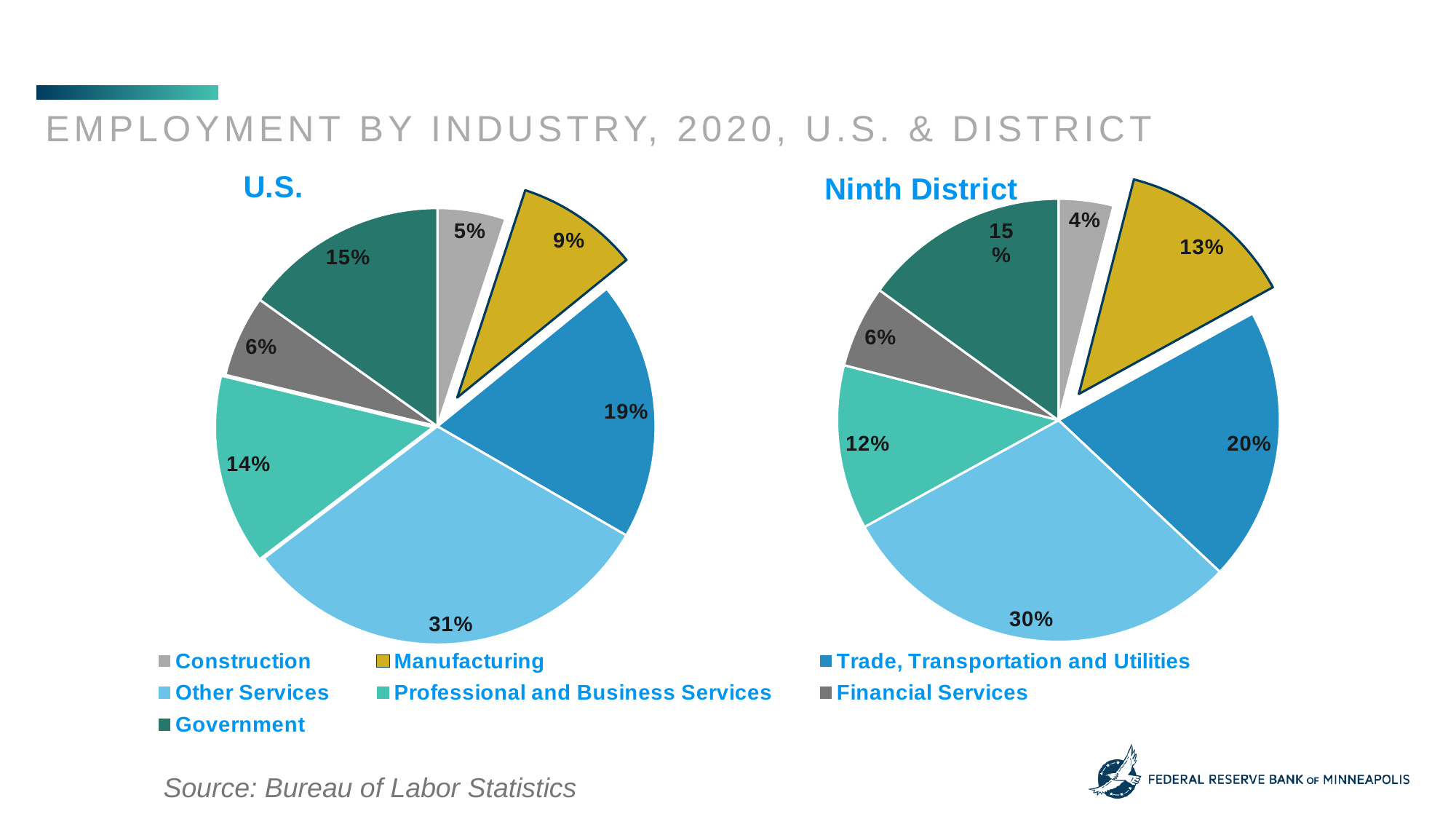
In the U.S. pie chart, what share of employment is in Manufacturing? 9% In the Ninth District pie chart, which industry has the smallest share? Construction In the U.S. pie chart, what share of employment is in Trade, Transportation and Utilities? 19% In the Ninth District pie chart, what share of employment is in Other Services? 30% What is the difference between the Manufacturing share in the Ninth District pie chart and the Manufacturing share in the U.S. pie chart? 4 percentage points What type of chart is used on this slide? Pie chart In the Ninth District pie chart, what share of employment is in Government? 15% Is the Professional and Business Services share larger in the U.S. pie chart or the Ninth District pie chart? U.S. What is the source cited for the charts on this slide? Bureau of Labor Statistics How many industry categories does each pie chart show? 7 In the Ninth District pie chart, what share of employment is in Manufacturing? 13% In the U.S. pie chart, which industry has the largest share? Other Services